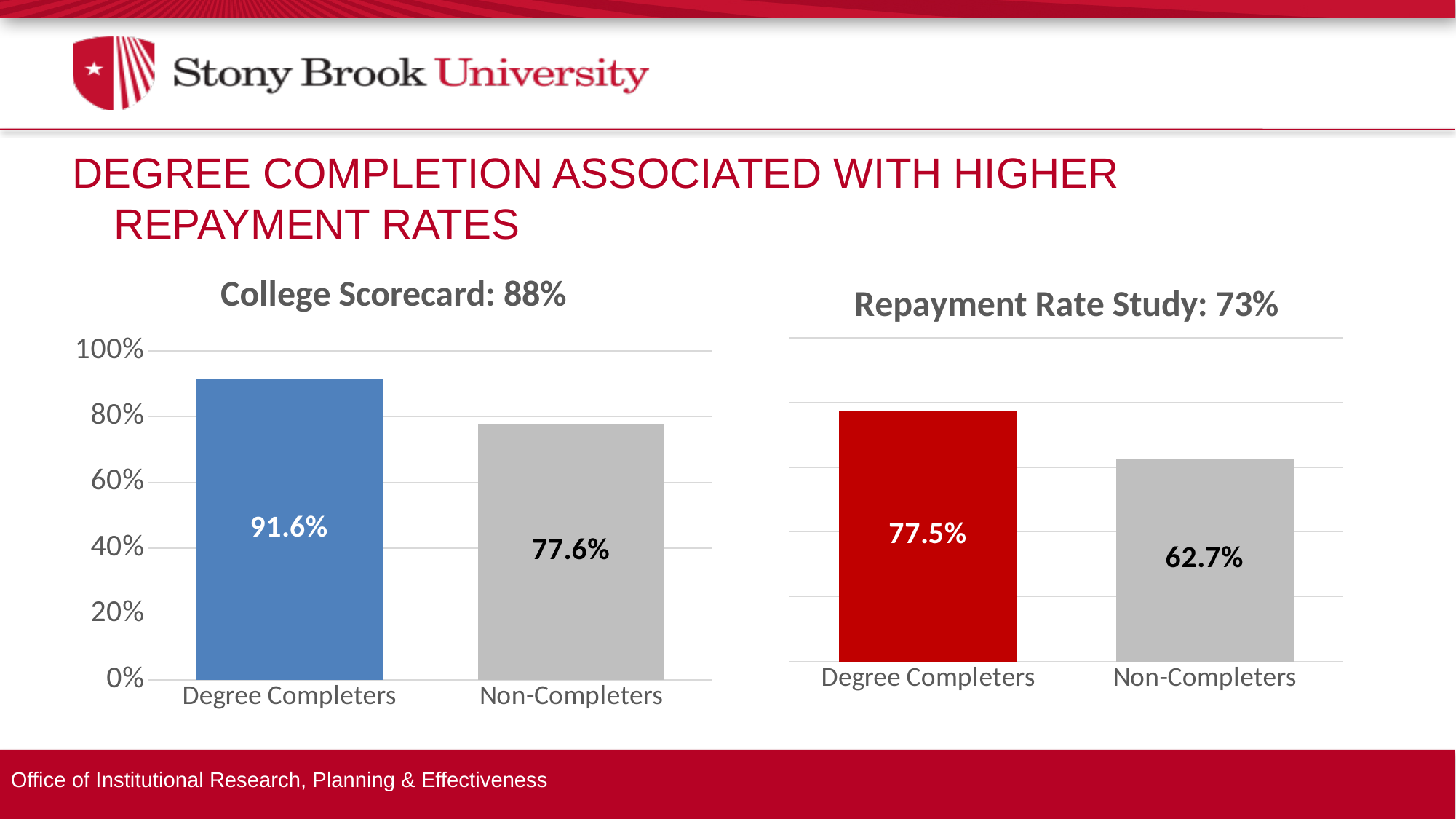
In the 'College Scorecard: 88%' chart, what is the difference between Degree Completers and Non-Completers? 14.0% In the 'College Scorecard: 88%' chart, what is the value for Degree Completers? 91.6% In the 'College Scorecard: 88%' chart, which category has the highest value? Degree Completers What kind of chart is the 'College Scorecard: 88%' chart? Bar chart In the 'Repayment Rate Study: 73%' chart, what is the difference between Degree Completers and Non-Completers? 14.8% In the 'Repayment Rate Study: 73%' chart, which category has the lowest value? Non-Completers In the 'College Scorecard: 88%' chart, is the value for Degree Completers greater or less than 80%? greater In the 'Repayment Rate Study: 73%' chart, what is the value for Non-Completers? 62.7% In the 'College Scorecard: 88%' chart, what is the value for Non-Completers? 77.6% In the 'Repayment Rate Study: 73%' chart, what is the value for Degree Completers? 77.5% Which is larger: Non-Completers in the 'College Scorecard: 88%' chart or Degree Completers in the 'Repayment Rate Study: 73%' chart? Non-Completers in the College Scorecard chart How many categories are shown in the 'Repayment Rate Study: 73%' chart? 2